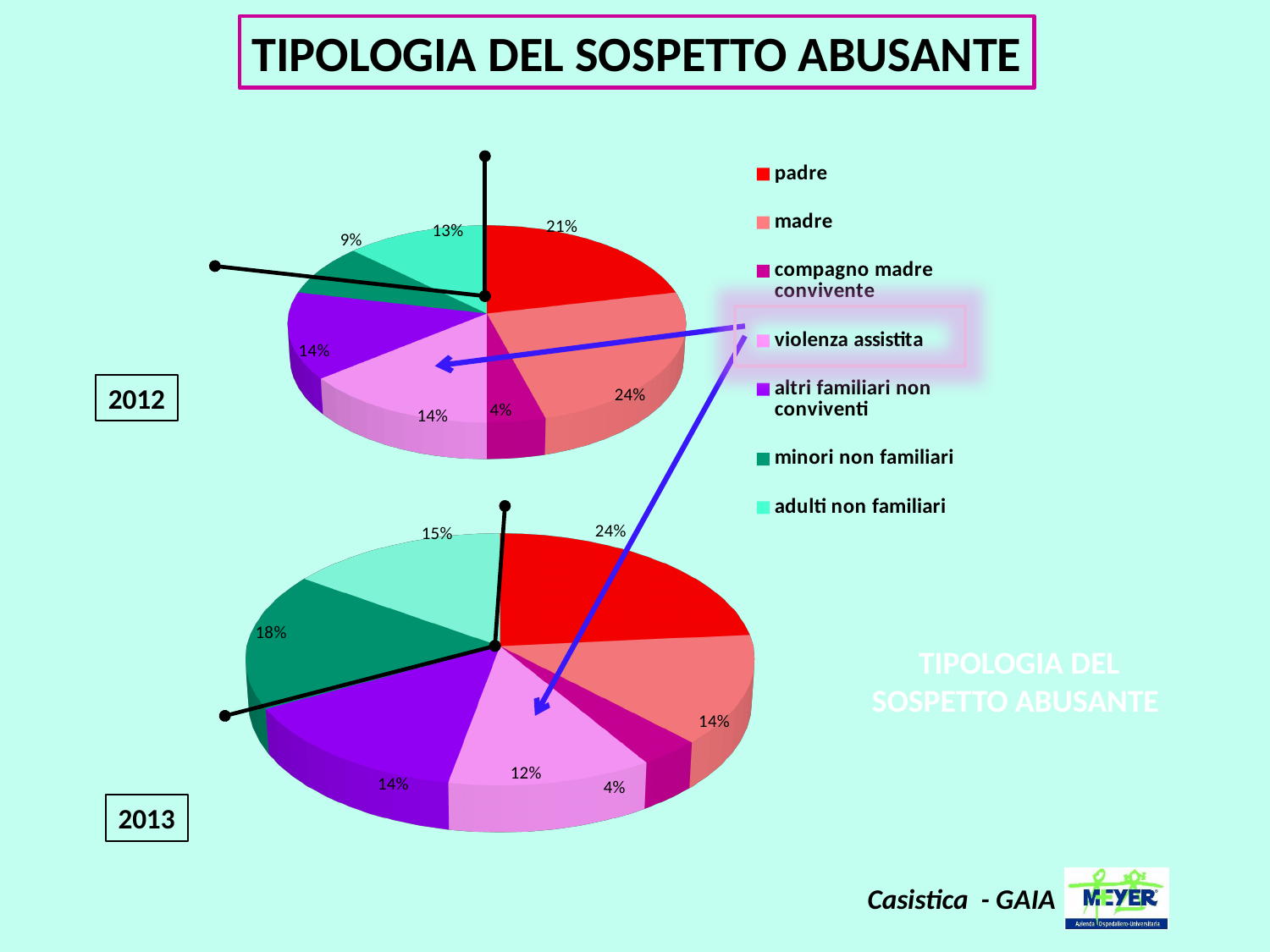
In the 2013 pie chart, which category has the largest share? padre In the 2012 pie chart, which category has the largest share? madre Which legend entry is highlighted with a box on the slide? violenza assistita In the 2013 pie chart, what percentage is shown for violenza assistita? 12% In the 2012 pie chart, which category has the smallest share? compagno madre convivente In the 2012 pie chart, what percentage is shown for madre? 24% How many categories does the legend list? 7 In the 2013 pie chart, which is larger: the share for minori non familiari or the share for adulti non familiari? minori non familiari In the 2012 pie chart, what percentage is shown for padre? 21% In the 2013 pie chart, what percentage is shown for minori non familiari? 18% What type of chart is used for the 2012 and 2013 data? pie chart What is the difference between the padre share in 2013 and the padre share in 2012? 3%